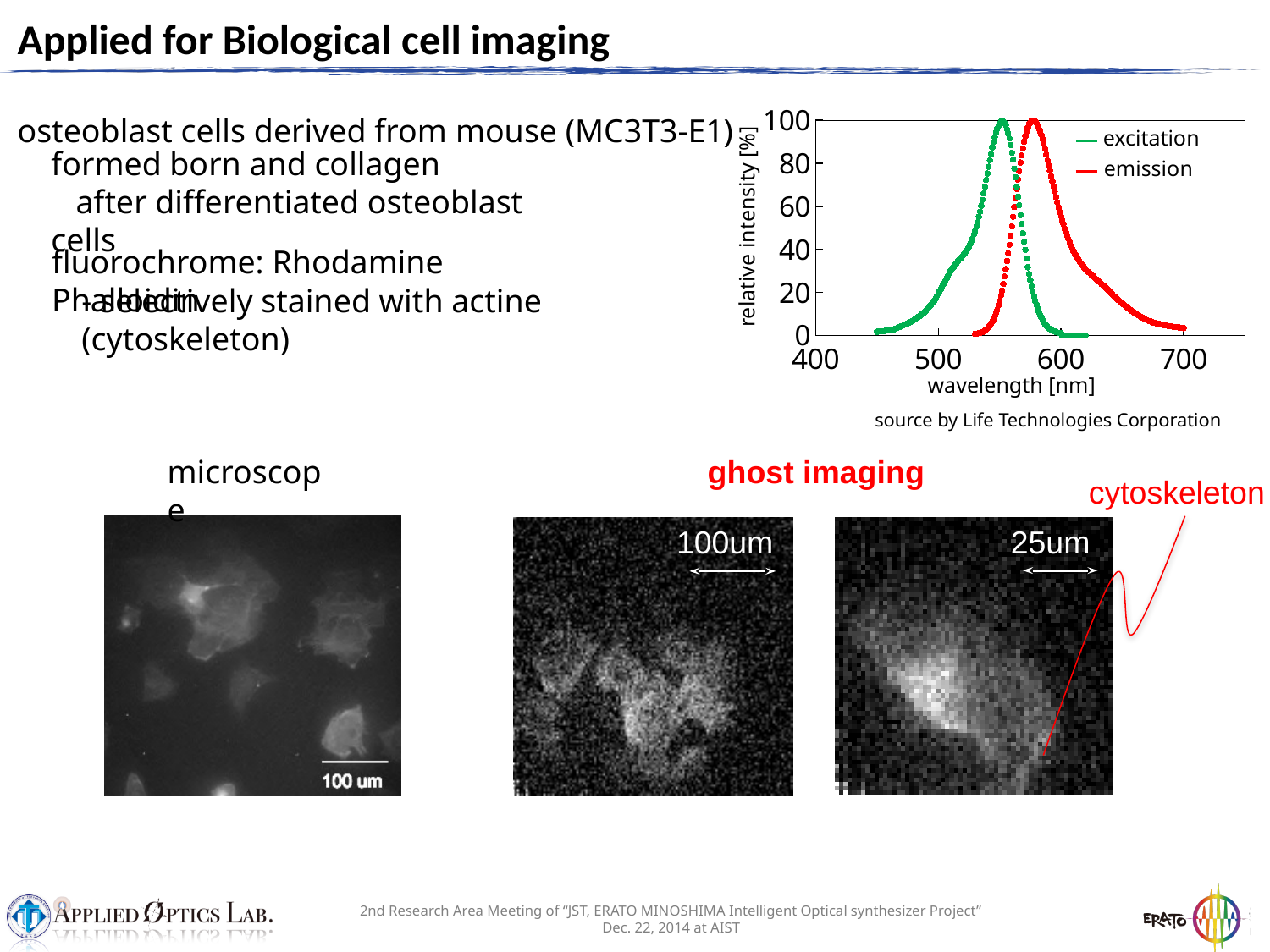
What colour is used for the emission series in the chart? red How many series does the chart legend list? 2 At 650 nm, which series has the higher relative intensity, excitation or emission? emission Is the relative intensity of the emission series at 650 nm greater or less than 20? less Which series reaches its peak at the shorter wavelength, excitation or emission? excitation Is the relative intensity of the excitation series at 450 nm greater or less than 20? less Is the relative intensity of the excitation series at 600 nm greater or less than 20? less What kind of chart is shown on the slide? scatter plot What are the two series named in the chart legend? excitation and emission Which series reaches its peak at the longer wavelength, excitation or emission? emission Does the emission series rise or fall as wavelength increases from 600 nm to 700 nm? fall Does the excitation series rise or fall as wavelength increases from 450 nm to 550 nm? rise